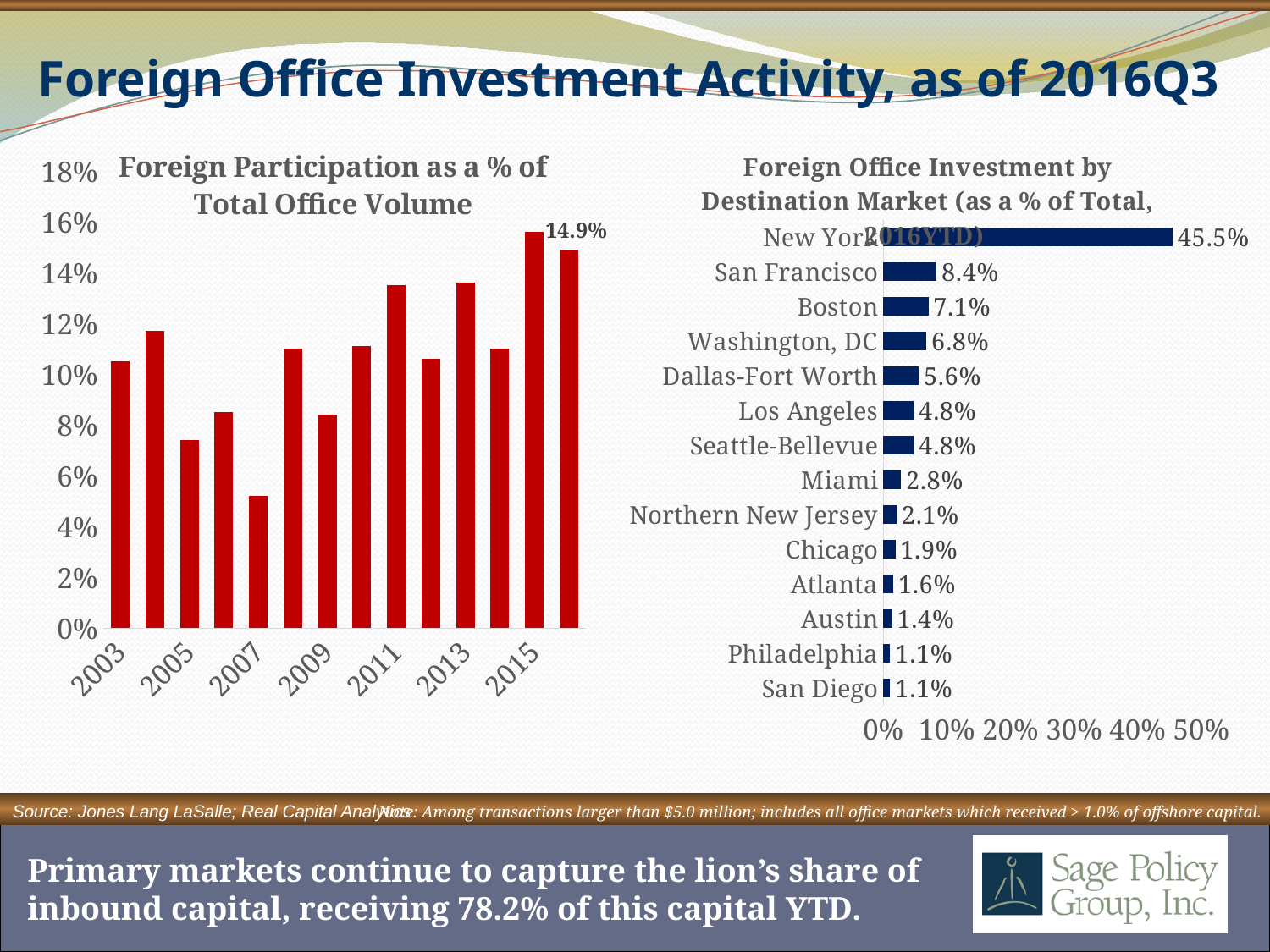
In the 'Foreign Office Investment by Destination Market' chart, what is the value for Miami? 2.8% In the 'Foreign Office Investment by Destination Market' chart, how much larger is New York's share than San Francisco's? 37.1% How many bars are plotted in the 'Foreign Participation as a % of Total Office Volume' chart? 14 What kind of chart is the 'Foreign Participation as a % of Total Office Volume' chart? bar chart How many destination markets are listed in the 'Foreign Office Investment by Destination Market' chart? 14 In the 'Foreign Office Investment by Destination Market' chart, which is larger: Washington, DC or Dallas-Fort Worth? Washington, DC In the 'Foreign Participation as a % of Total Office Volume' chart, what value is printed as a data label on the rightmost bar? 14.9% In the 'Foreign Participation as a % of Total Office Volume' chart, is the value for 2015 greater or less than 14%? greater In the 'Foreign Office Investment by Destination Market' chart, what is the value for Boston? 7.1% In the 'Foreign Participation as a % of Total Office Volume' chart, is the value for 2007 greater or less than 6%? less In the 'Foreign Office Investment by Destination Market' chart, what percentage is shown for New York? 45.5% In the 'Foreign Office Investment by Destination Market' chart, which market has the highest share? New York